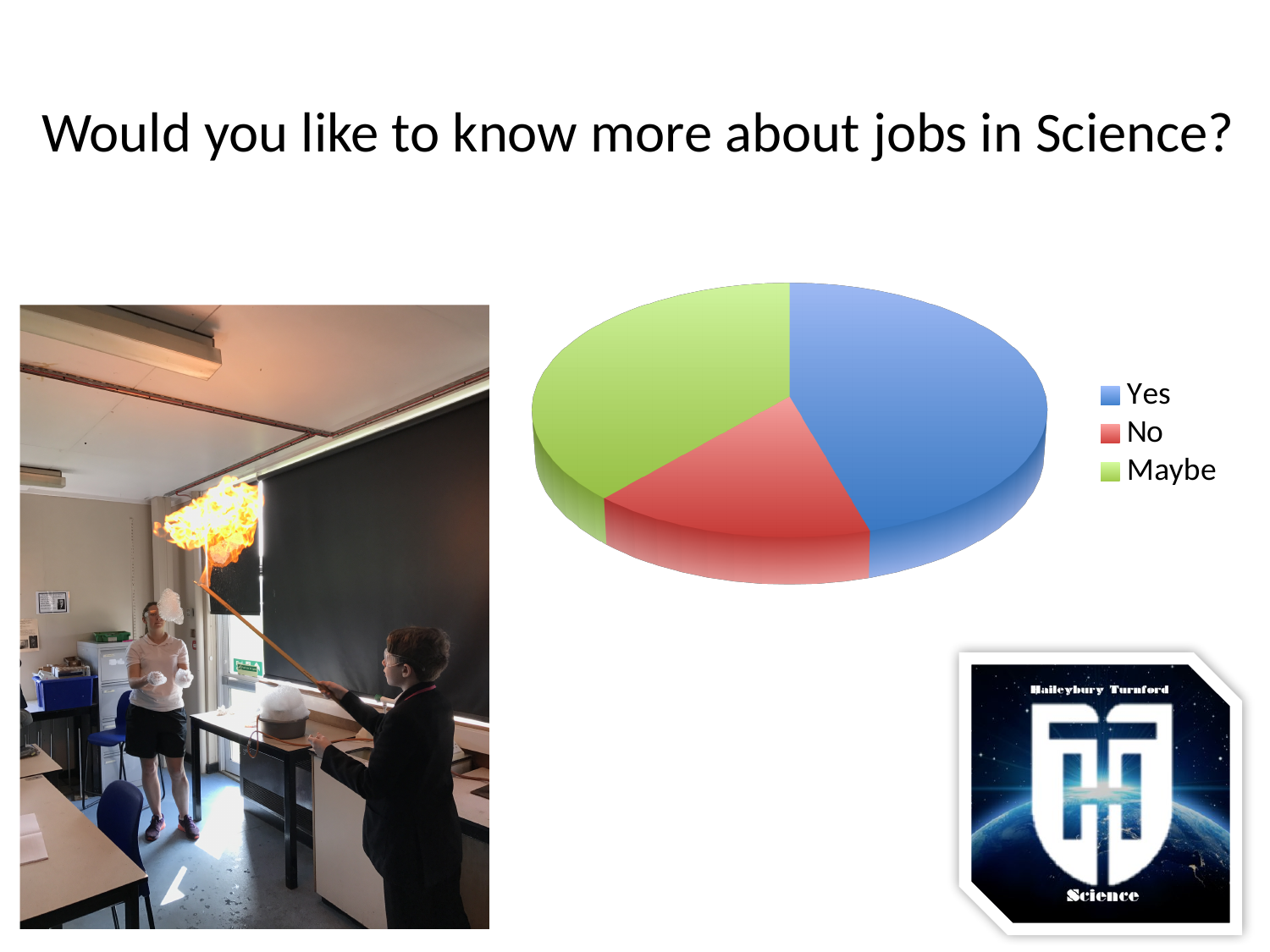
What kind of chart is shown on the slide? pie chart Which slice is larger in the pie chart, Yes or No? Yes How many entries does the legend of the pie chart list? 3 What colour is the Maybe slice in the pie chart? green Which category has the smallest slice in the pie chart? No What question does the slide title ask about the pie chart? Would you like to know more about jobs in Science? How many slices does the pie chart have? 3 Which category has the largest slice in the pie chart? Yes Which slice is larger in the pie chart, Maybe or No? Maybe